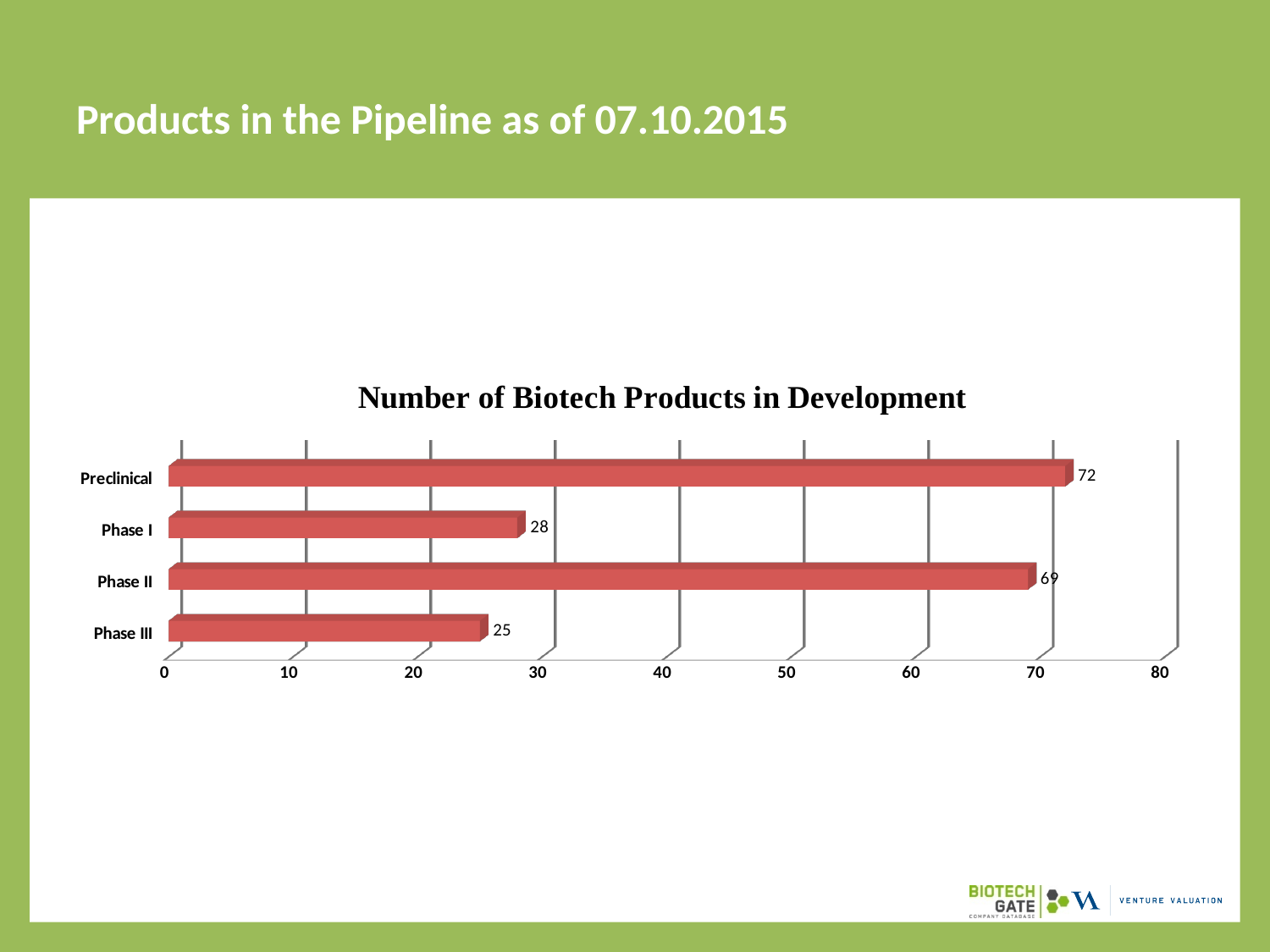
How many stages (categories) are shown in the chart? 4 What is the value shown for Phase I? 28 Which has more products in development, Phase I or Phase II? Phase II What is the difference between the Phase I and Phase III values? 3 Which stage has the highest number of products in development? Preclinical Which stage has the lowest number of products in development? Phase III What is the title of the chart? Number of Biotech Products in Development What type of chart is shown on the slide? Bar chart What is the number of biotech products in development at the Preclinical stage? 72 What is the value shown for Phase III? 25 What is the difference between the Preclinical and Phase II values? 3 What is the value shown for Phase II? 69